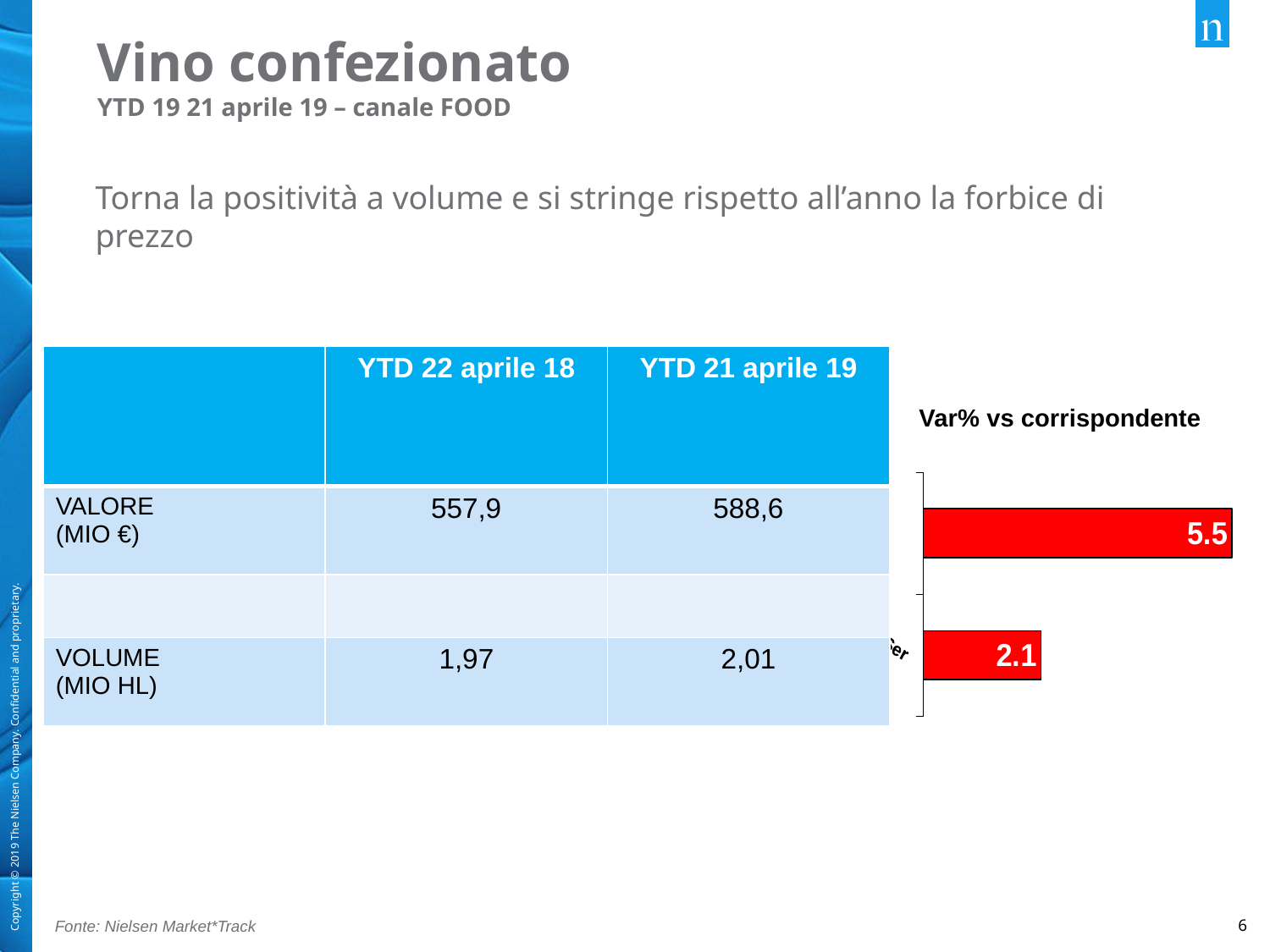
In the "Var% vs corrispondente" chart, is the top bar value larger or smaller than the bottom bar value? larger In the "Var% vs corrispondente" chart, what is the difference between the top bar value and the bottom bar value? 3.4 What is the title of the chart on the right of the slide? Var% vs corrispondente In the "Var% vs corrispondente" chart, what is the value of the top bar (the one aligned with the VALORE row)? 5.5 In the "Var% vs corrispondente" chart, which bar has the lowest value, the top one or the bottom one? the bottom one In the "Var% vs corrispondente" chart, what is the value of the bottom bar (the one aligned with the VOLUME row)? 2.1 In the "Var% vs corrispondente" chart, which bar has the highest value, the top one or the bottom one? the top one How many bars does the "Var% vs corrispondente" chart show? 2 What kind of chart is shown on the right of the slide under "Var% vs corrispondente"? bar chart What colour are the bars in the "Var% vs corrispondente" chart? red